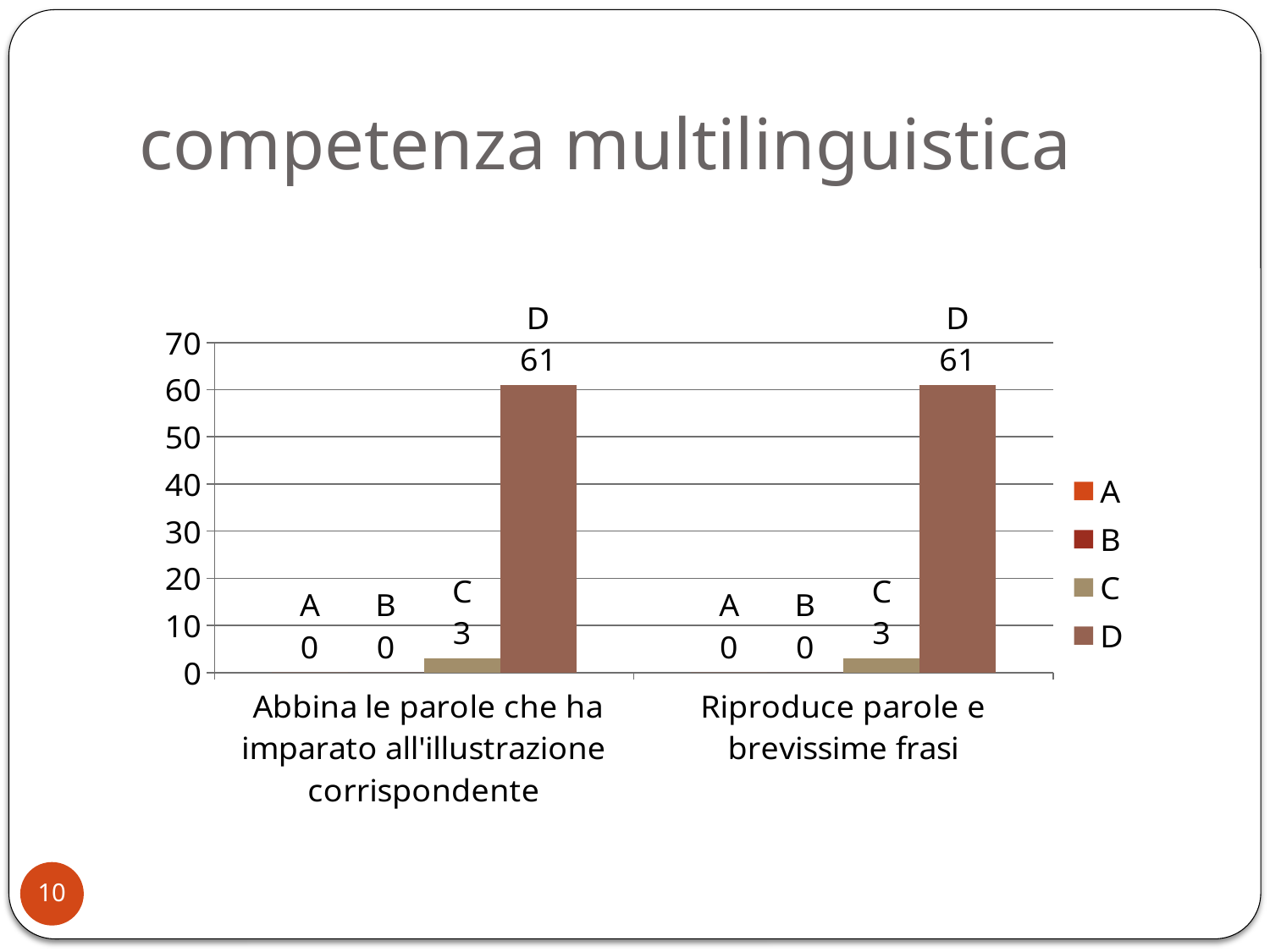
How many categories are shown on the x axis of the chart? 2 What is the value for series A in the category "Riproduce parole e brevissime frasi"? 0 Which is larger in the category "Riproduce parole e brevissime frasi": the value for series C or the value for series D? D What kind of chart is shown on the slide? bar chart What is the value for series B in the category "Abbina le parole che ha imparato all'illustrazione corrispondente"? 0 What is the value for series D in the category "Abbina le parole che ha imparato all'illustrazione corrispondente"? 61 What is the value for series C in the category "Riproduce parole e brevissime frasi"? 3 Which series has the highest value in the category "Riproduce parole e brevissime frasi"? D Is the value for series D in the category "Abbina le parole che ha imparato all'illustrazione corrispondente" greater or less than 50? greater How many series does the legend list? 4 What is the difference between the values for series D and series C in the category "Abbina le parole che ha imparato all'illustrazione corrispondente"? 58 What is the title of the slide containing the chart? competenza multilinguistica